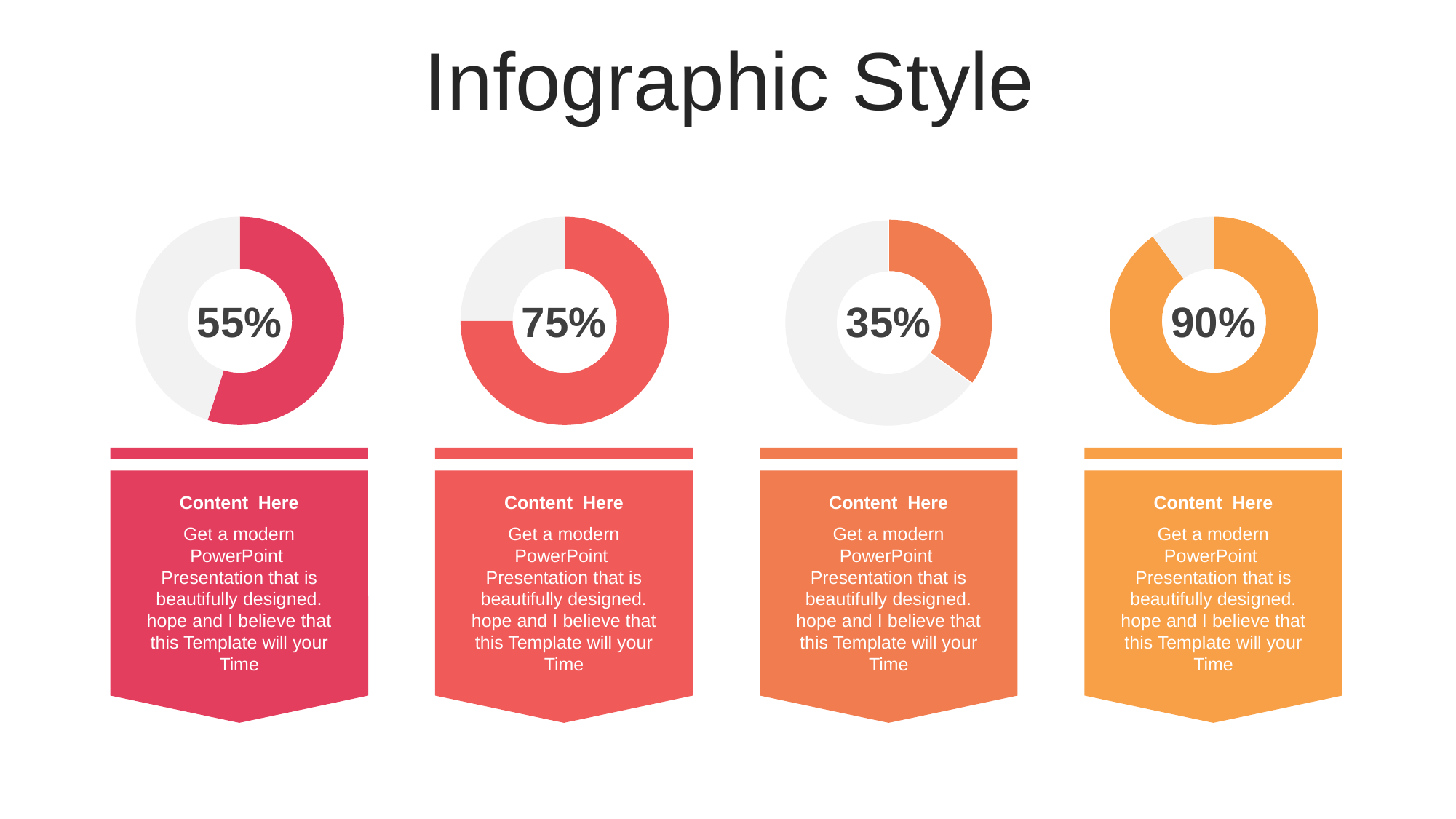
Which donut chart on the slide shows the lowest percentage? The third chart from the left (35%) What percentage is shown in the center of the second donut chart from the left? 75% How many donut charts are shown on the slide? 4 What percentage is shown in the center of the leftmost donut chart? 55% What is the difference between the percentage in the second donut chart and the percentage in the third donut chart? 40% What percentage is shown in the center of the rightmost donut chart? 90% What is the difference between the percentage in the rightmost donut chart and the percentage in the leftmost donut chart? 35% What percentage is shown in the center of the third donut chart from the left? 35% Which is larger, the percentage in the leftmost donut chart or the percentage in the second donut chart? The second donut chart (75%) What colour is the filled portion of the rightmost donut chart? Orange Which donut chart on the slide shows the highest percentage? The rightmost chart (90%) What kind of chart is used to display the percentages on the slide? Donut chart